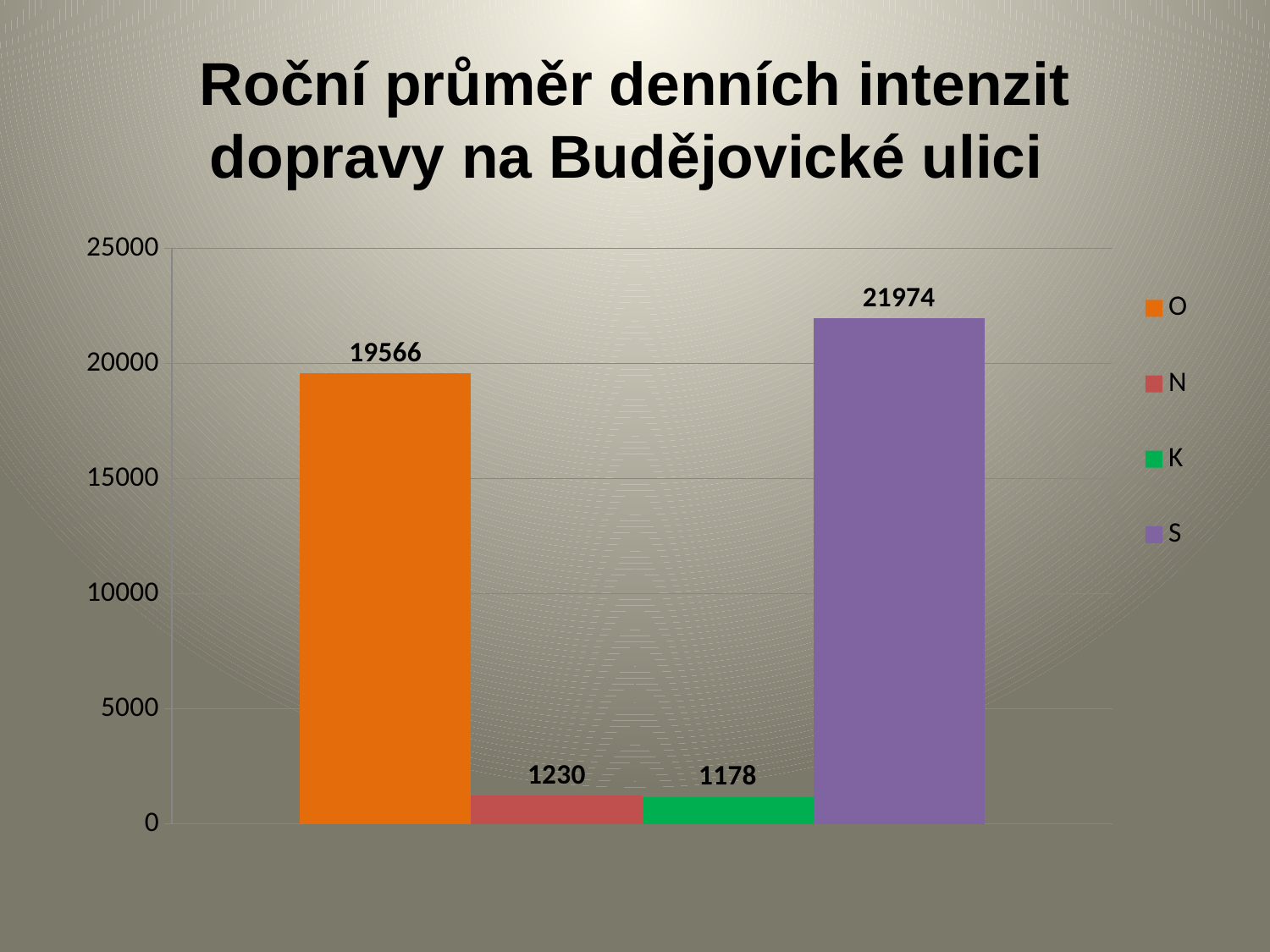
What is the difference between the values for S and O? 2408 What kind of chart is shown on the slide? bar chart What is the value for O? 19566 Which series has the highest value? S Is the value for O greater or less than 20000? less Which is larger, the value for O or the value for S? S What is the value for K? 1178 How many series does the legend list? 4 What is the value for N? 1230 Which series has the lowest value? K What is the value for S? 21974 What is the difference between the values for N and K? 52